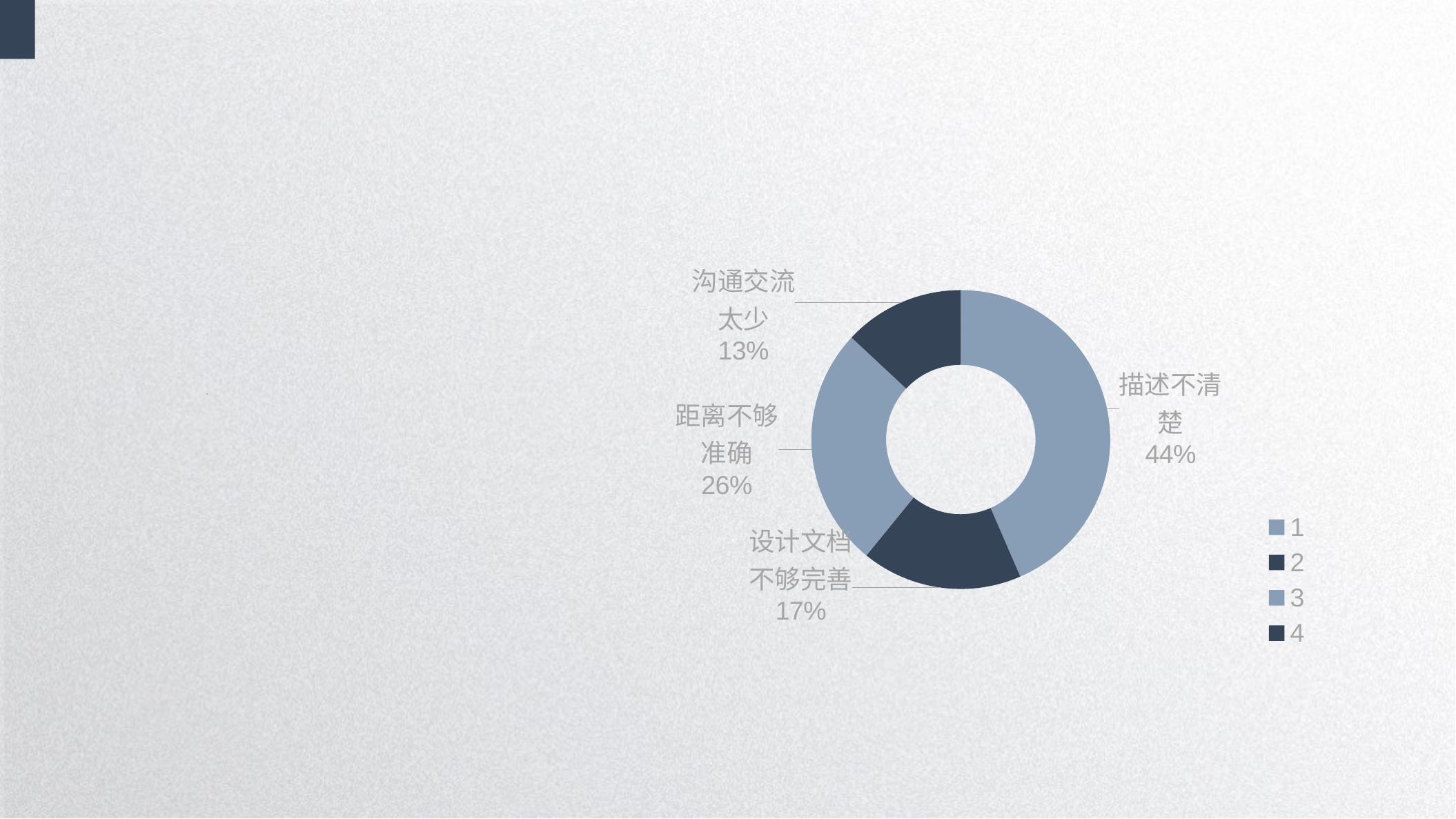
What is the difference in percentage points between 描述不清楚 and 距离不够准确? 18 Which category has the smallest share of the chart? 沟通交流太少 Which is larger, the share for 设计文档不够完善 or the share for 沟通交流太少? 设计文档不够完善 How many slices does the chart have? 4 What kind of chart is shown on the slide? doughnut chart What is the combined share of 距离不够准确 and 沟通交流太少? 39% Which category has the largest share of the chart? 描述不清楚 What percentage is shown for 距离不够准确? 26% What percentage is shown for 沟通交流太少? 13% What share of the chart does 描述不清楚 account for? 44% How many entries does the legend list? 4 What percentage is shown for 设计文档不够完善? 17%